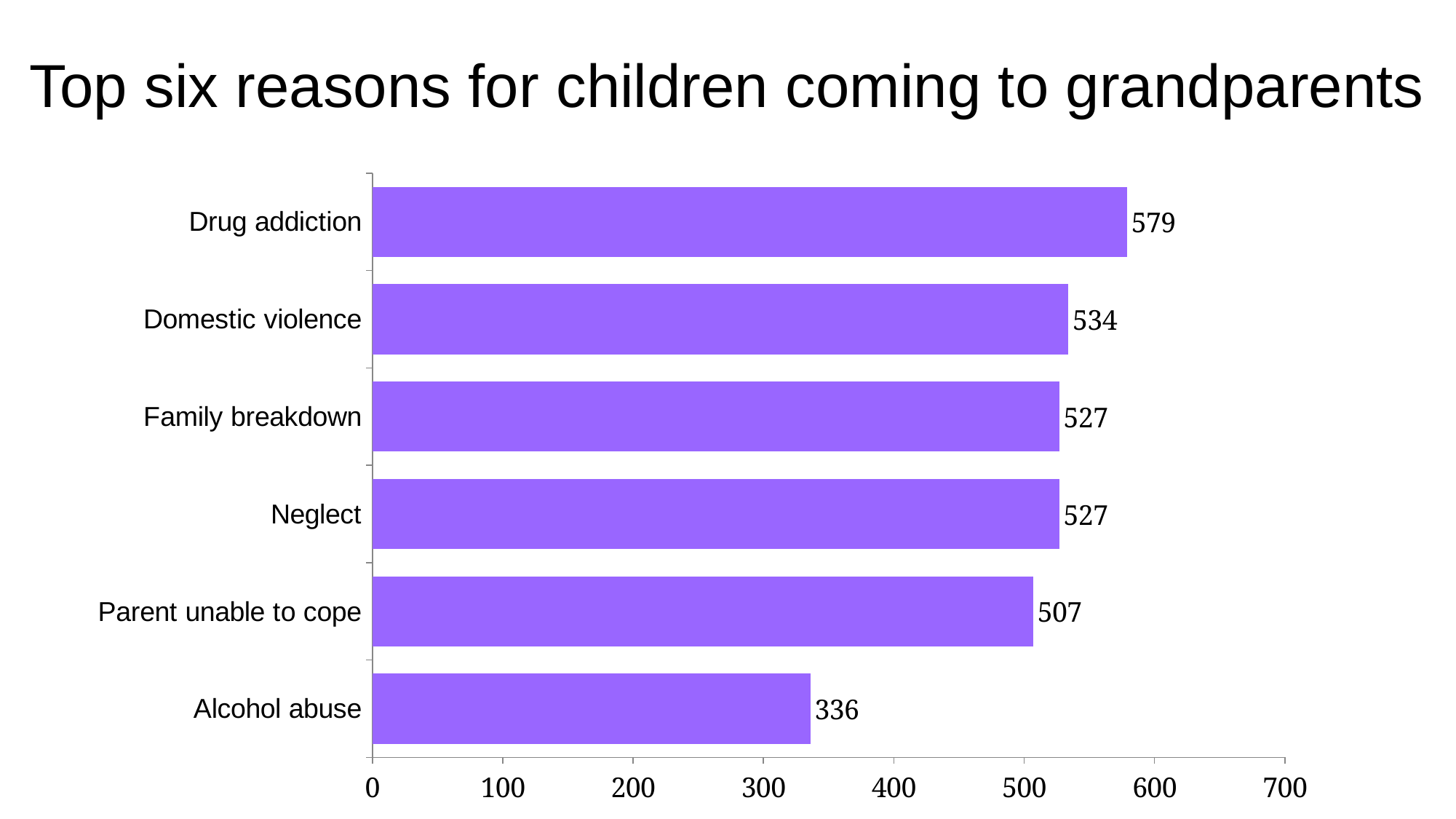
What is the value for Alcohol abuse? 336 Is the value for Alcohol abuse greater or less than 400? less Which reason has the highest value? Drug addiction What is the value for Parent unable to cope? 507 What is the title of the chart? Top six reasons for children coming to grandparents What kind of chart is shown on the slide? Bar chart What is the difference between the values for Domestic violence and Parent unable to cope? 27 What is the value for Drug addiction? 579 Which reason has the lowest value? Alcohol abuse Which is larger, the value for Domestic violence or the value for Alcohol abuse? Domestic violence How many reasons are shown in the chart? 6 What is the difference between the values for Drug addiction and Alcohol abuse? 243